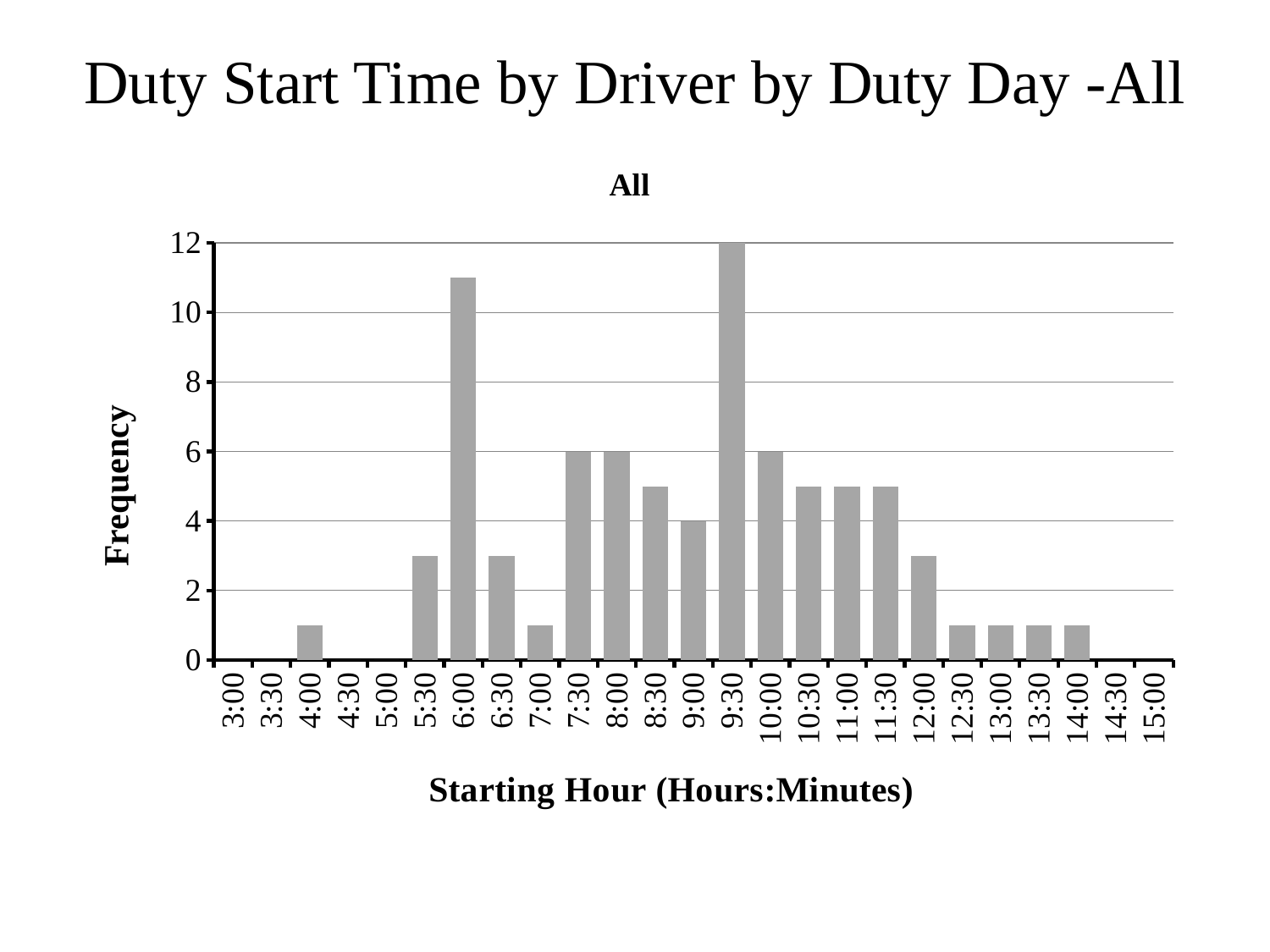
Which has a higher frequency, the 6:00 starting hour or the 7:30 starting hour? 6:00 What is the frequency for the 9:00 starting hour? 4 Is the frequency for the 6:00 starting hour greater or less than 10? greater What is the difference in frequency between the 9:30 and 7:30 starting hours? 6 What kind of chart is shown on the slide? bar chart What is the label of the x axis? Starting Hour (Hours:Minutes) Is the frequency for the 8:30 starting hour greater or less than 6? less What is the frequency for the 9:30 starting hour? 12 Which starting hour has the highest frequency? 9:30 Is the frequency for the 12:00 starting hour greater or less than 4? less How many starting hour categories are shown on the x axis? 25 What is the frequency for the 7:30 starting hour? 6